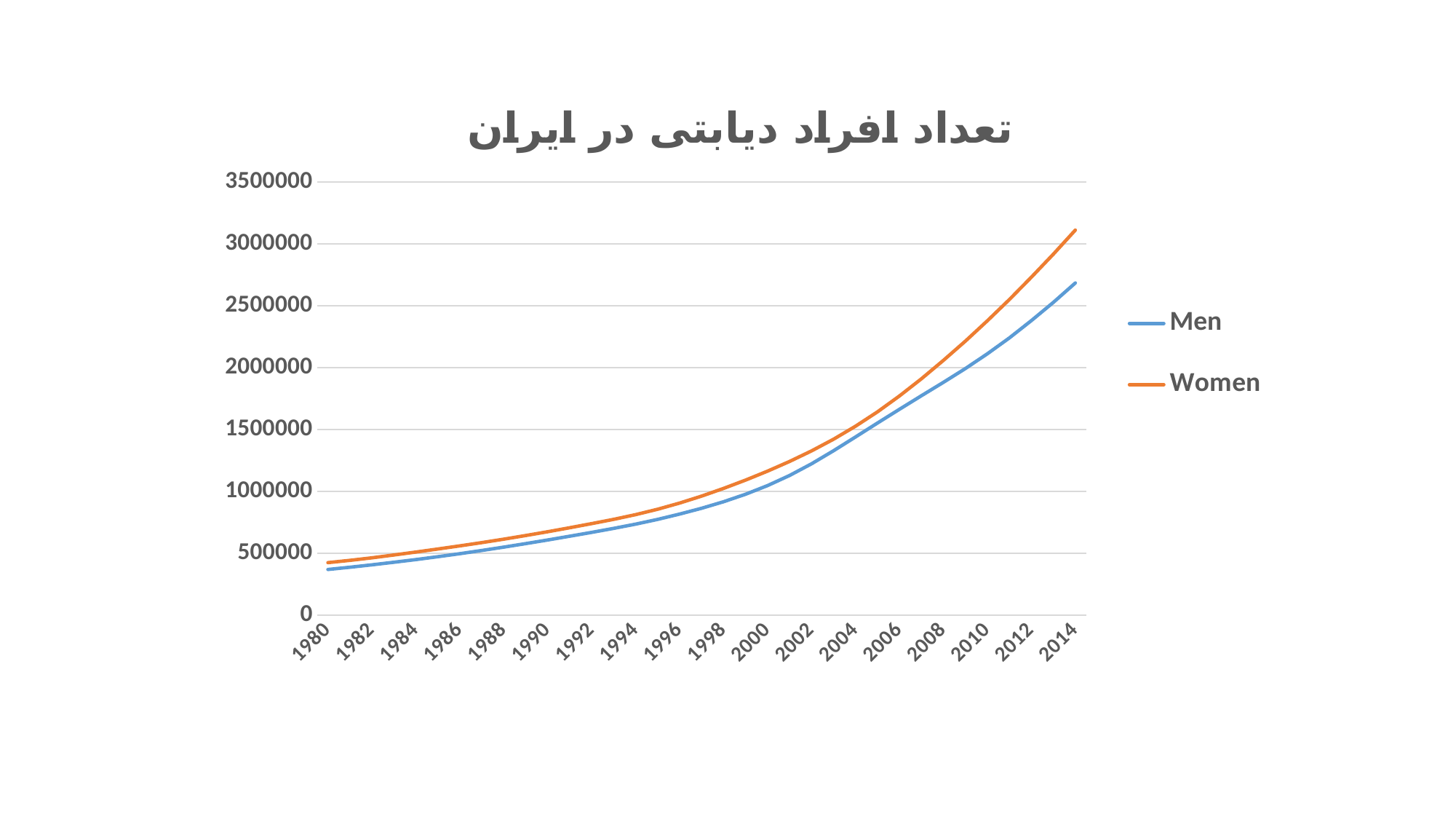
Which series is drawn in orange? Women Do the values for Men rise or fall from 1980 to 2014? rise In 2014, which series has the larger value, Men or Women? Women How many series does the legend list? 2 Is the value for Men in 2014 greater or less than 3000000? less Is the value for Men in 1980 greater or less than 500000? less Is the value for Women in 2014 greater or less than 3000000? greater Do the values for Women rise or fall from 1980 to 2014? rise How many year labels are shown on the x axis? 18 What type of chart is shown on the slide? line chart What are the names of the two series in the legend? Men and Women